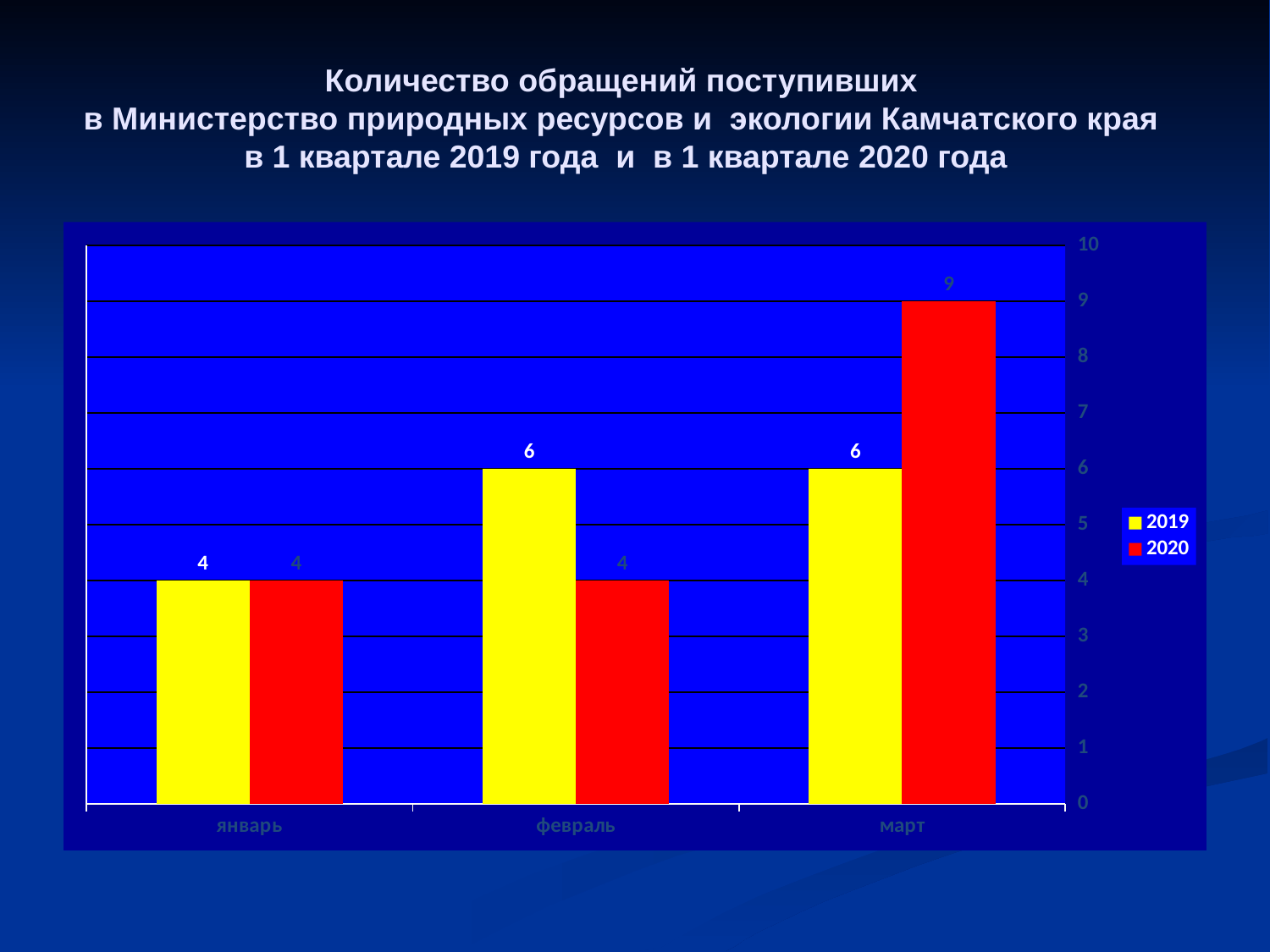
Which month has the highest value for the 2020 series? март How many series does the legend list? 2 How many categories are shown on the x axis? 3 What is the difference between the 2020 and 2019 values in март? 3 What type of chart is shown on the slide? bar chart Which colour represents the 2020 series? red What is the value for 2019 in март? 6 Which month has the lowest value for the 2019 series? январь What is the value for 2020 in март? 9 What is the value for 2019 in февраль? 6 In февраль, which series has the larger value, 2019 or 2020? 2019 What is the value for 2020 in январь? 4